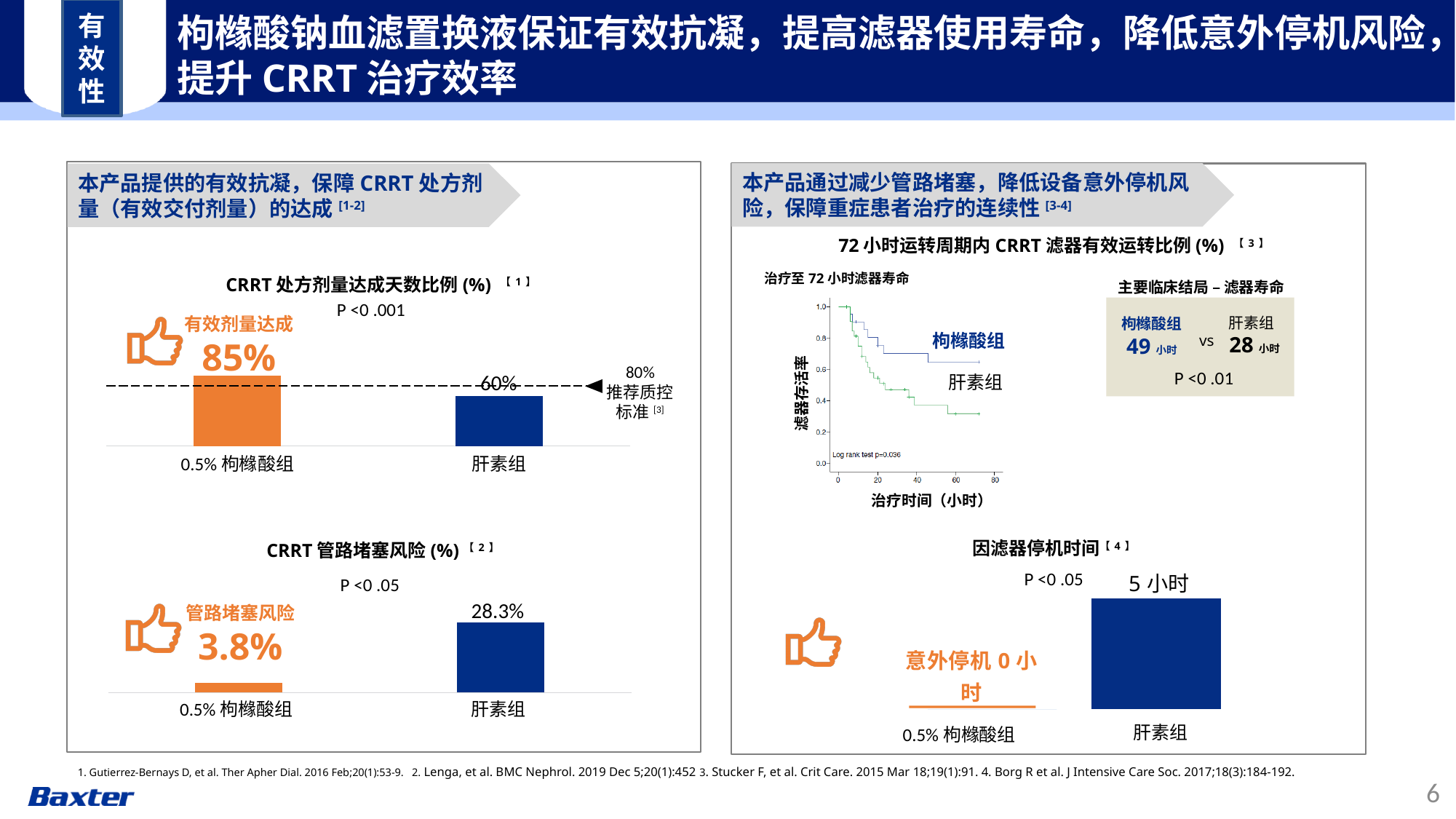
In the chart titled CRRT 处方剂量达成天数比例 (%), what level does the dashed reference line (推荐质控标准) mark? 80% In the chart titled CRRT 管路堵塞风险 (%), which group has the lower value? 0.5% 枸橼酸组 In the chart titled CRRT 处方剂量达成天数比例 (%), what is the difference between the 0.5% 枸橼酸组 and 肝素组 values? 25% In the chart titled CRRT 管路堵塞风险 (%), what is the value for 肝素组? 28.3% In the chart titled CRRT 管路堵塞风险 (%), what is the value for 0.5% 枸橼酸组? 3.8% In the chart titled 因滤器停机时间, what is the value for 0.5% 枸橼酸组? 0 小时 In the chart titled 因滤器停机时间, what is the value for 肝素组? 5 小时 In the chart titled CRRT 处方剂量达成天数比例 (%), what is the value for 肝素组? 60% In the chart titled CRRT 管路堵塞风险 (%), what is the difference between 肝素组 and 0.5% 枸橼酸组? 24.5% What kind of chart is the 治疗至 72 小时滤器寿命 chart on the right side of the slide? Line chart (survival curve) In the 治疗至 72 小时滤器寿命 chart, how many groups (curves) are plotted? 2 In the chart titled CRRT 处方剂量达成天数比例 (%), what is the value for 0.5% 枸橼酸组? 85%